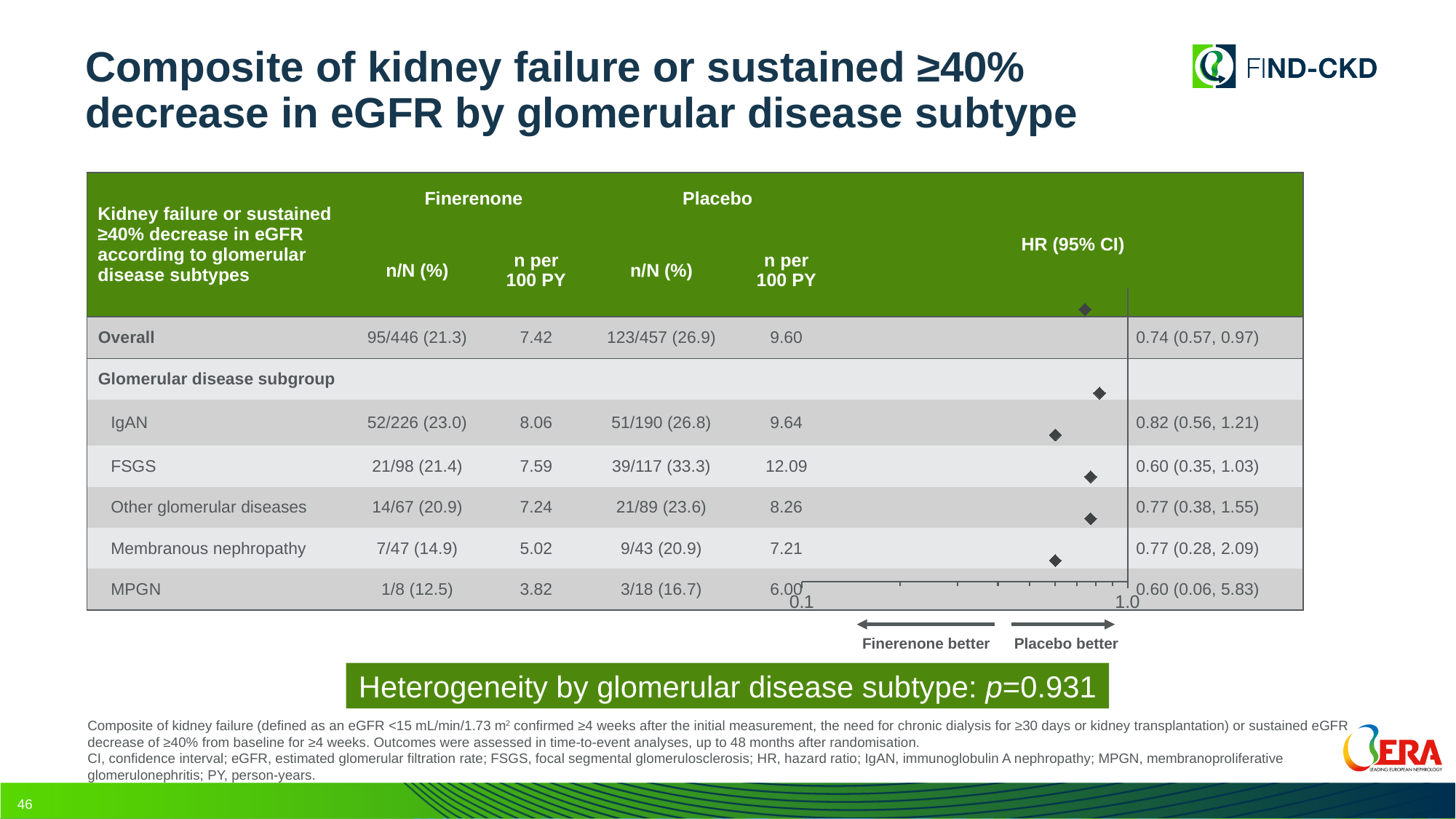
What is the hazard ratio (95% CI) for the FSGS subgroup? 0.60 (0.35, 1.03) What are the two tick values shown on the x axis of the forest plot? 0.1 and 1.0 What is the difference between the hazard ratio for IgAN and the hazard ratio for FSGS? 0.22 Is the hazard ratio for the Overall group greater or less than 1.0? less What kind of chart is used to display the hazard ratios? Forest plot What is the hazard ratio (95% CI) for the Overall group in the forest plot? 0.74 (0.57, 0.97) Which has the larger hazard ratio, IgAN or Membranous nephropathy? IgAN Which glomerular disease subgroup has the highest hazard ratio? IgAN What is the hazard ratio for the IgAN subgroup? 0.82 According to the arrows below the forest plot, which treatment is favoured by hazard ratios to the left of 1.0? Finerenone How many hazard ratio point estimates are plotted in the forest plot? 6 What is the hazard ratio (95% CI) for the MPGN subgroup? 0.60 (0.06, 5.83)